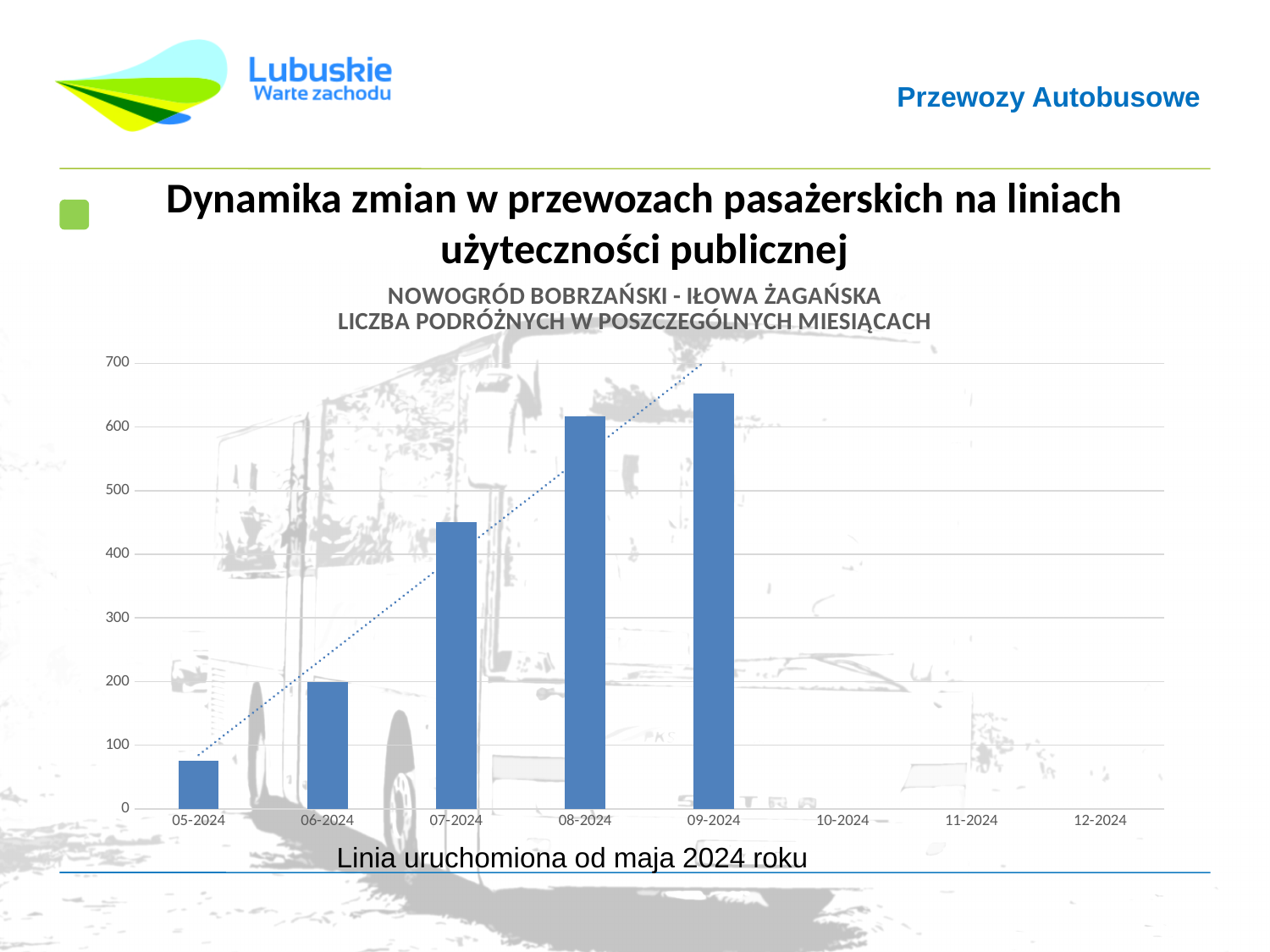
Is the value for 08-2024 greater or less than 600? greater What kind of chart is shown on the slide? bar chart Is the value for 09-2024 greater or less than 700? less Which month has the highest number of passengers? 09-2024 Is the value for 07-2024 greater or less than 400? greater Which month has the lowest number of passengers? 05-2024 Which is larger, the value for 06-2024 or the value for 07-2024? 07-2024 Do the values rise or fall from 05-2024 to 09-2024? rise Which is larger, the value for 08-2024 or the value for 09-2024? 09-2024 What is the highest value shown on the vertical axis? 700 How many months have a bar plotted in the chart? 5